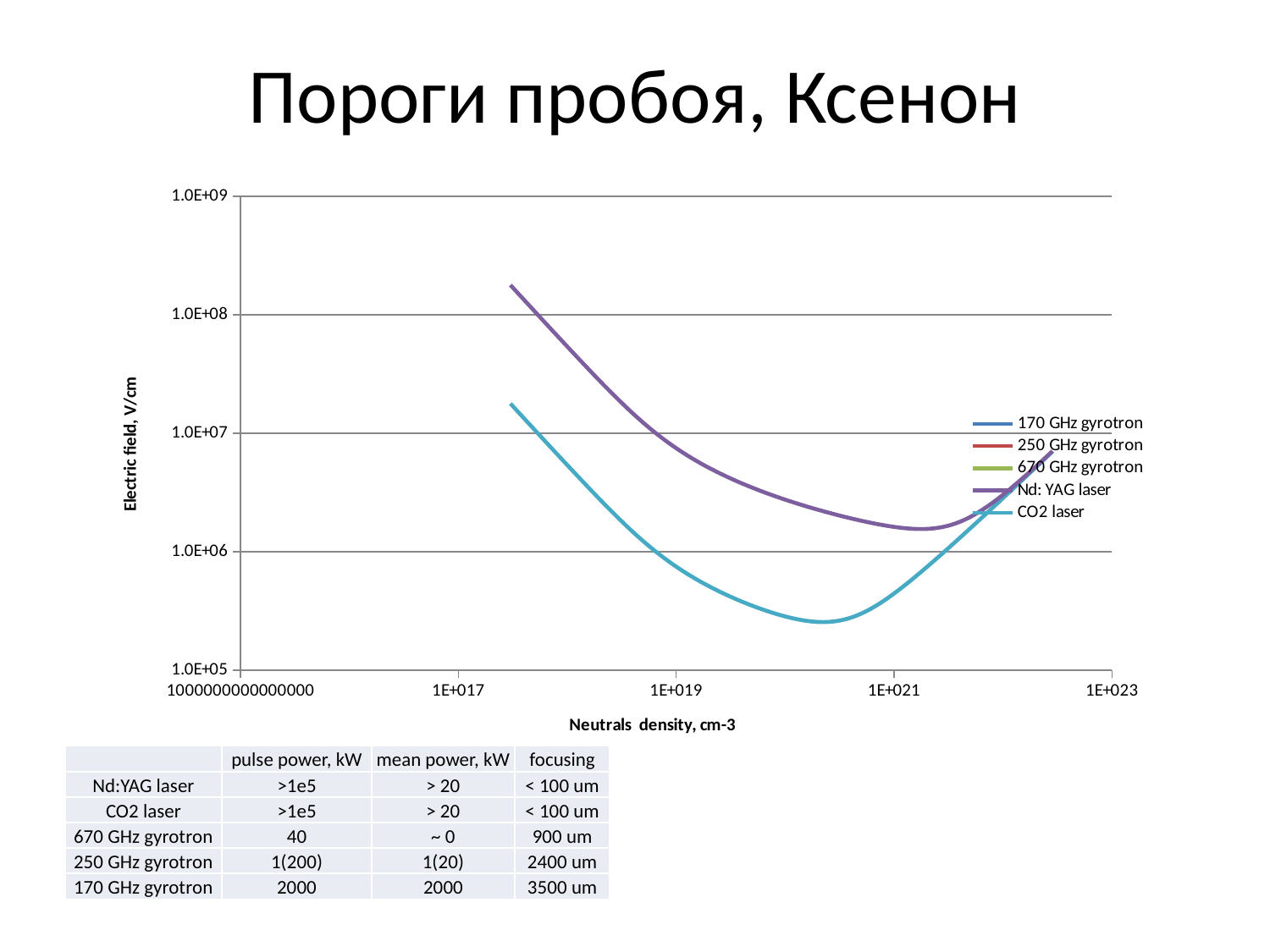
At a neutrals density of 1E+19, which curve is higher: Nd: YAG laser or CO2 laser? Nd: YAG laser Is the value of the CO2 laser curve at its left end greater or less than 1.0E+07? greater Is the lowest value of the CO2 laser curve greater or less than 1.0E+06? less What kind of chart is shown on the slide? line chart How many series does the chart legend list? 5 How does the CO2 laser curve behave as neutrals density increases from 1E+17 to 1E+21? it falls, reaches a minimum, then rises Which of the two plotted curves lies lower over the whole plotted range? CO2 laser How many labelled tick values are shown on the vertical axis? 5 What is the label of the vertical axis of the chart? Electric field, V/cm Is the value of the Nd: YAG laser curve at its left end greater or less than 1.0E+08? greater What is the label of the horizontal axis of the chart? Neutrals density, cm-3